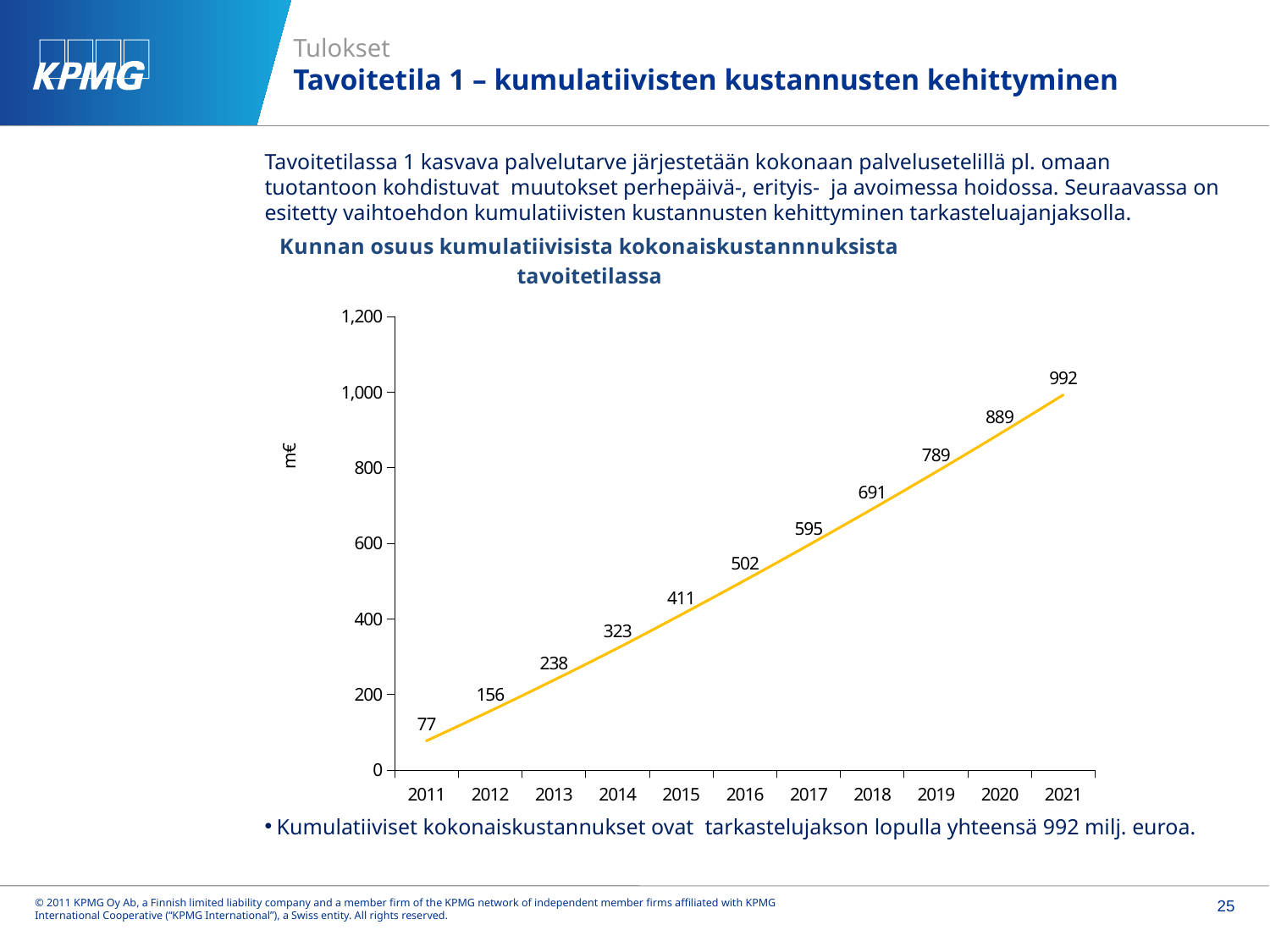
What is the value for 2015? 411 Which year has the highest value? 2021 What kind of chart is shown? line chart What is the value for 2011? 77 What is the value for 2019? 789 What is the difference between the values for 2016 and 2013? 264 How many years are plotted on the x axis? 11 Is the value for 2018 greater or less than 600? greater Which year has the lowest value? 2011 Which is larger, the value for 2017 or the value for 2014? 2017 What is the difference between the values for 2021 and 2020? 103 Do the values rise or fall from 2011 to 2021? rise